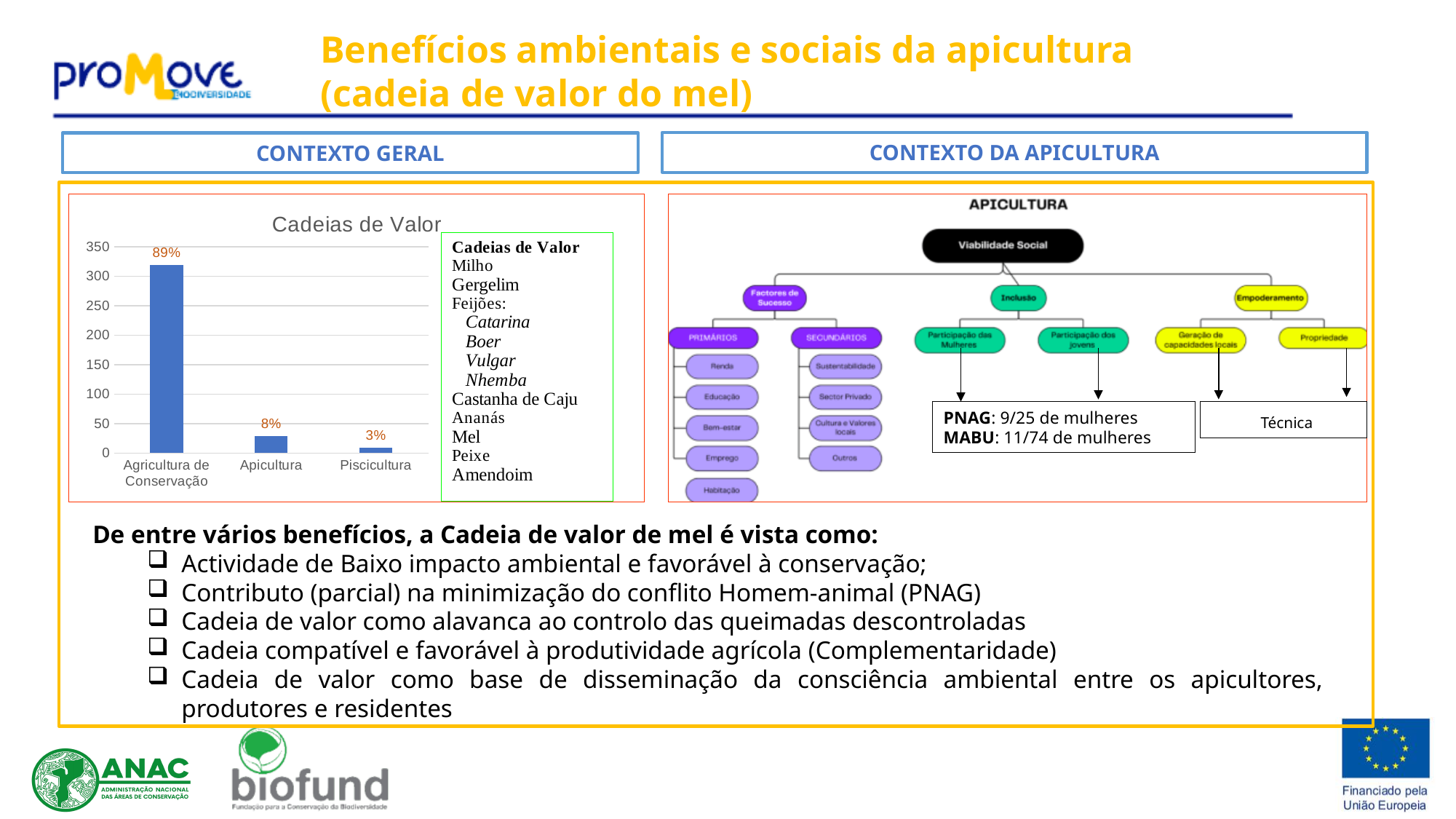
How many categories are shown in the 'Cadeias de Valor' chart? 3 What is the title of the bar chart on the left of the slide? Cadeias de Valor In the 'Cadeias de Valor' chart, what data label is shown above the bar for Apicultura? 8% In the 'Cadeias de Valor' chart, which category has the lowest bar? Piscicultura In the 'Cadeias de Valor' chart, is the bar for Apicultura greater or less than 50? less In the 'Cadeias de Valor' chart, do the bar heights rise or fall from left to right across the categories? fall In the 'Cadeias de Valor' chart, what data label is shown above the bar for Piscicultura? 3% In the 'Cadeias de Valor' chart, which category has the highest bar? Agricultura de Conservação What kind of chart is the 'Cadeias de Valor' chart? bar chart In the 'Cadeias de Valor' chart, which is larger, the bar for Apicultura or the bar for Piscicultura? Apicultura In the 'Cadeias de Valor' chart, what data label is shown above the bar for Agricultura de Conservação? 89% In the 'Cadeias de Valor' chart, is the bar for Agricultura de Conservação greater or less than 300? greater